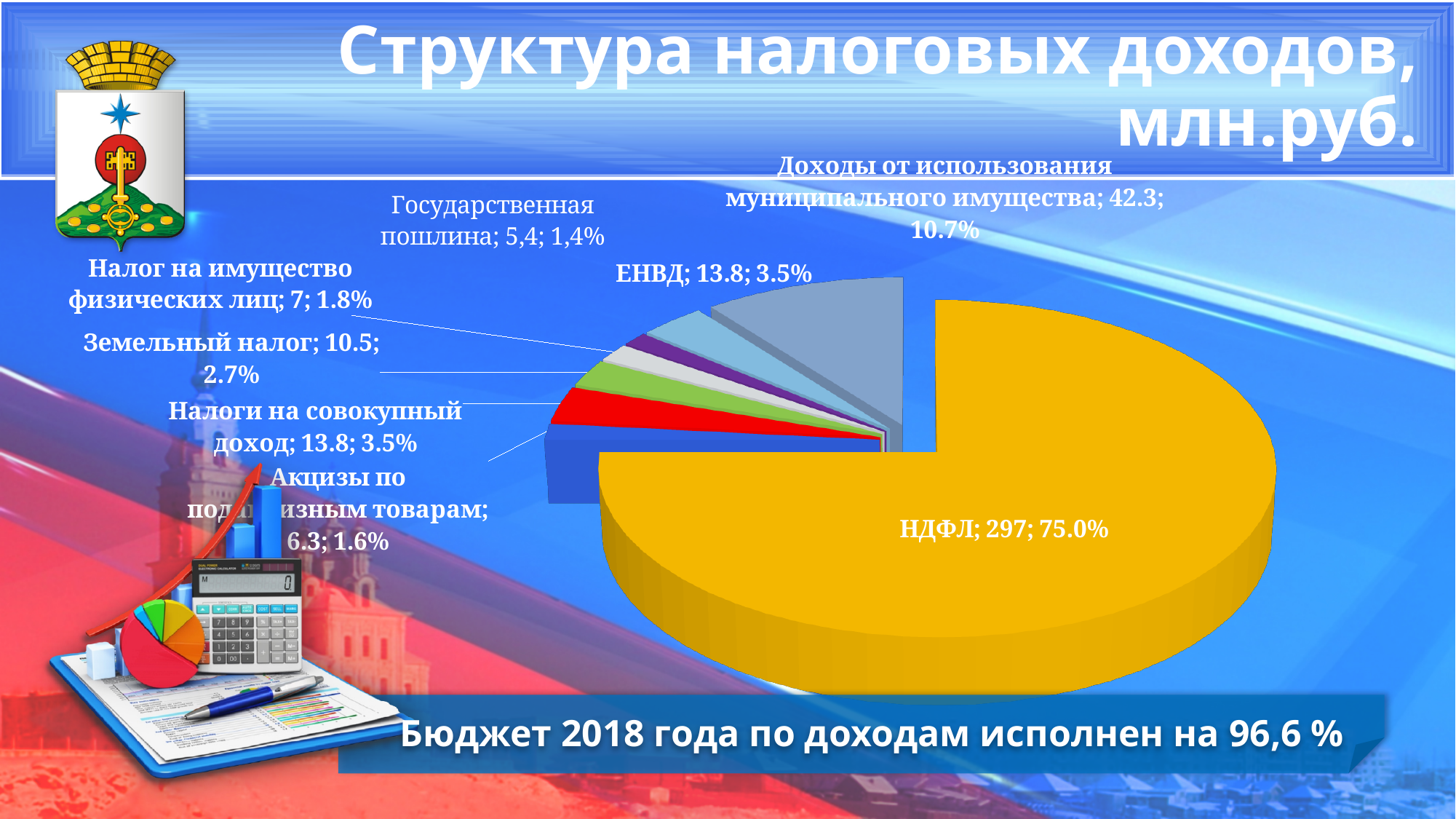
What is the title of the chart on the slide? Структура налоговых доходов, млн.руб. What share of the pie does НДФЛ represent? 75.0% What share of the pie does Земельный налог represent? 2.7% Which is larger: the value for Земельный налог or the value for Налог на имущество физических лиц? Земельный налог What is the difference between the values for Доходы от использования муниципального имущества and ЕНВД? 28.5 What is the value for Доходы от использования муниципального имущества? 42.3 Which category has the largest slice of the pie? НДФЛ What kind of chart is shown on the slide? pie chart How many categories are shown in the pie chart? 8 What is the value for НДФЛ in the pie chart? 297 Which category has the smallest slice of the pie? Государственная пошлина What is the value for Государственная пошлина? 5,4